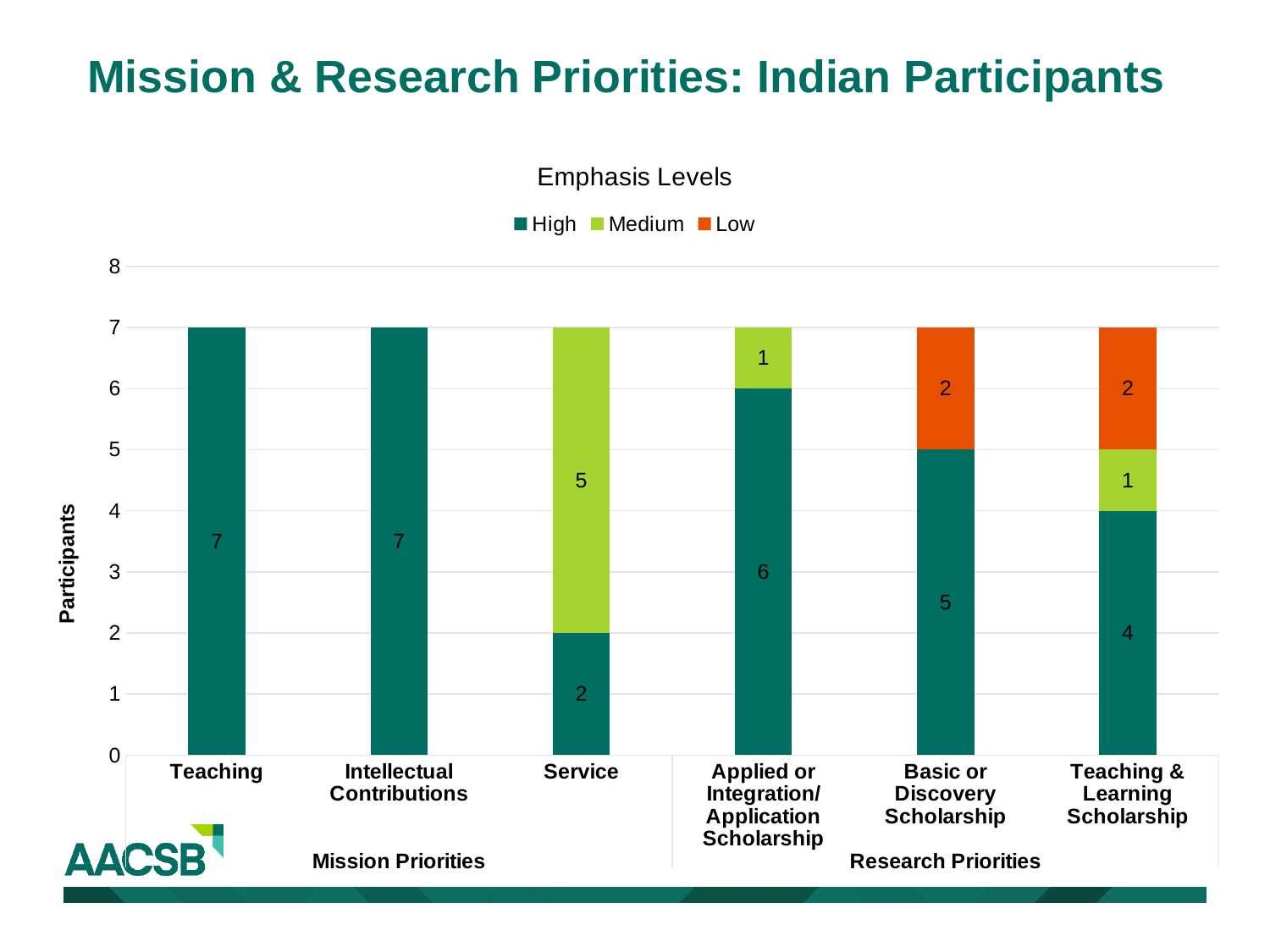
How many categories are shown on the x axis? 6 Which is larger: the High value for Intellectual Contributions or the High value for Teaching & Learning Scholarship? Intellectual Contributions What is the High value for Teaching & Learning Scholarship? 4 What is the High value for Teaching? 7 Which category has the lowest High value? Service What kind of chart is shown? Stacked bar chart What is the Low value for Basic or Discovery Scholarship? 2 What is the total of the stacked bar for Teaching & Learning Scholarship? 7 What is the difference between the High value for Applied or Integration/Application Scholarship and the High value for Basic or Discovery Scholarship? 1 What is the Medium value for Service? 5 How many series does the legend list? 3 What is the title of the chart? Emphasis Levels